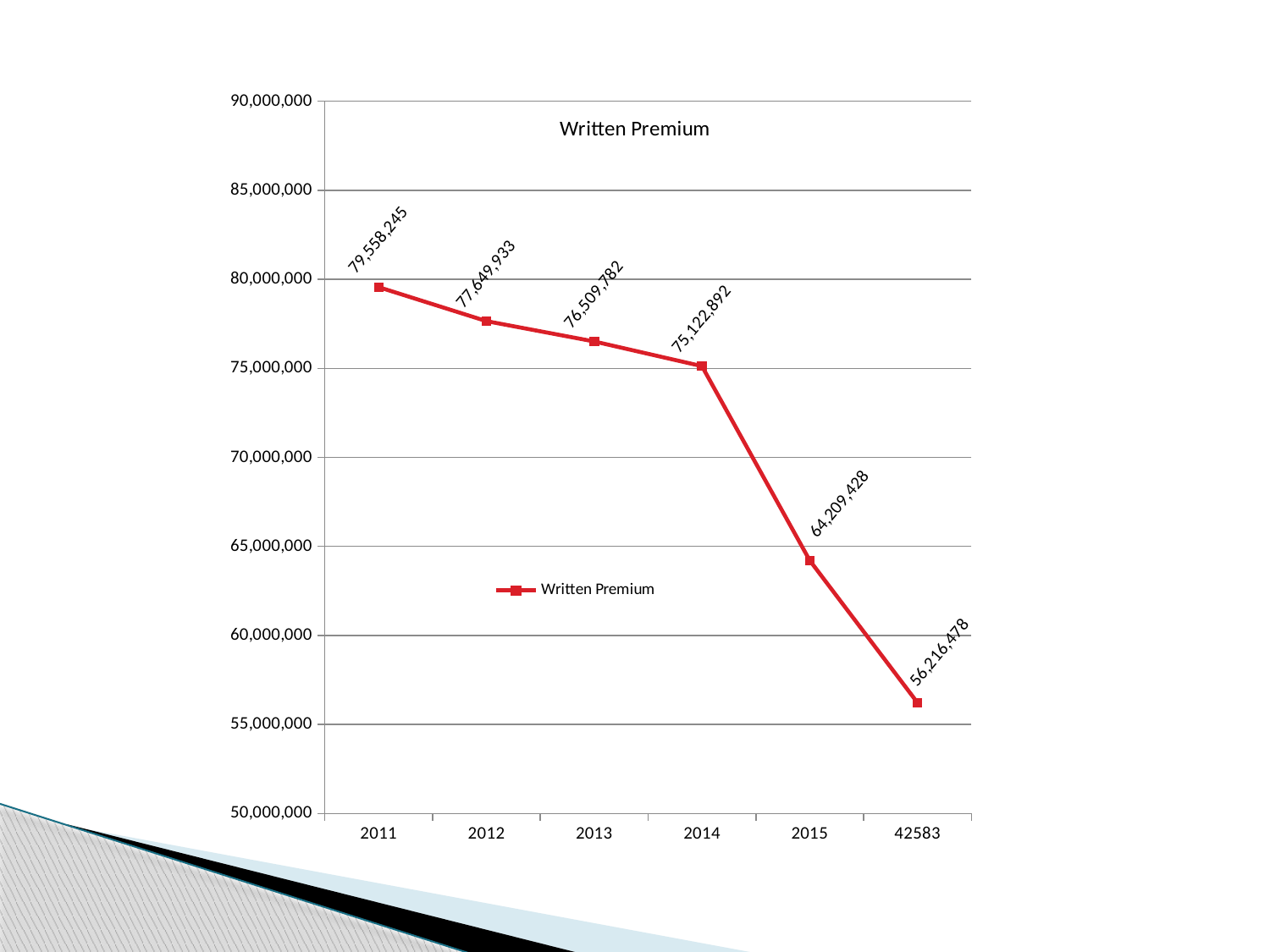
What is the difference between the Written Premium for 2011 and 2012? 1,908,312 What is the Written Premium value for the category labelled 42583? 56,216,478 Which category has the lowest Written Premium? 42583 What kind of chart is shown on the slide? line chart What is the Written Premium value for 2014? 75,122,892 What is the difference between the Written Premium for 2014 and 2015? 10,913,464 Do the Written Premium values rise or fall from 2011 to the last category? fall Is the Written Premium for 2015 greater or less than 65,000,000? less Which is larger, the Written Premium for 2013 or for 2015? 2013 Which category has the highest Written Premium? 2011 What is the Written Premium value for 2011? 79,558,245 How many data points are plotted on the chart? 6